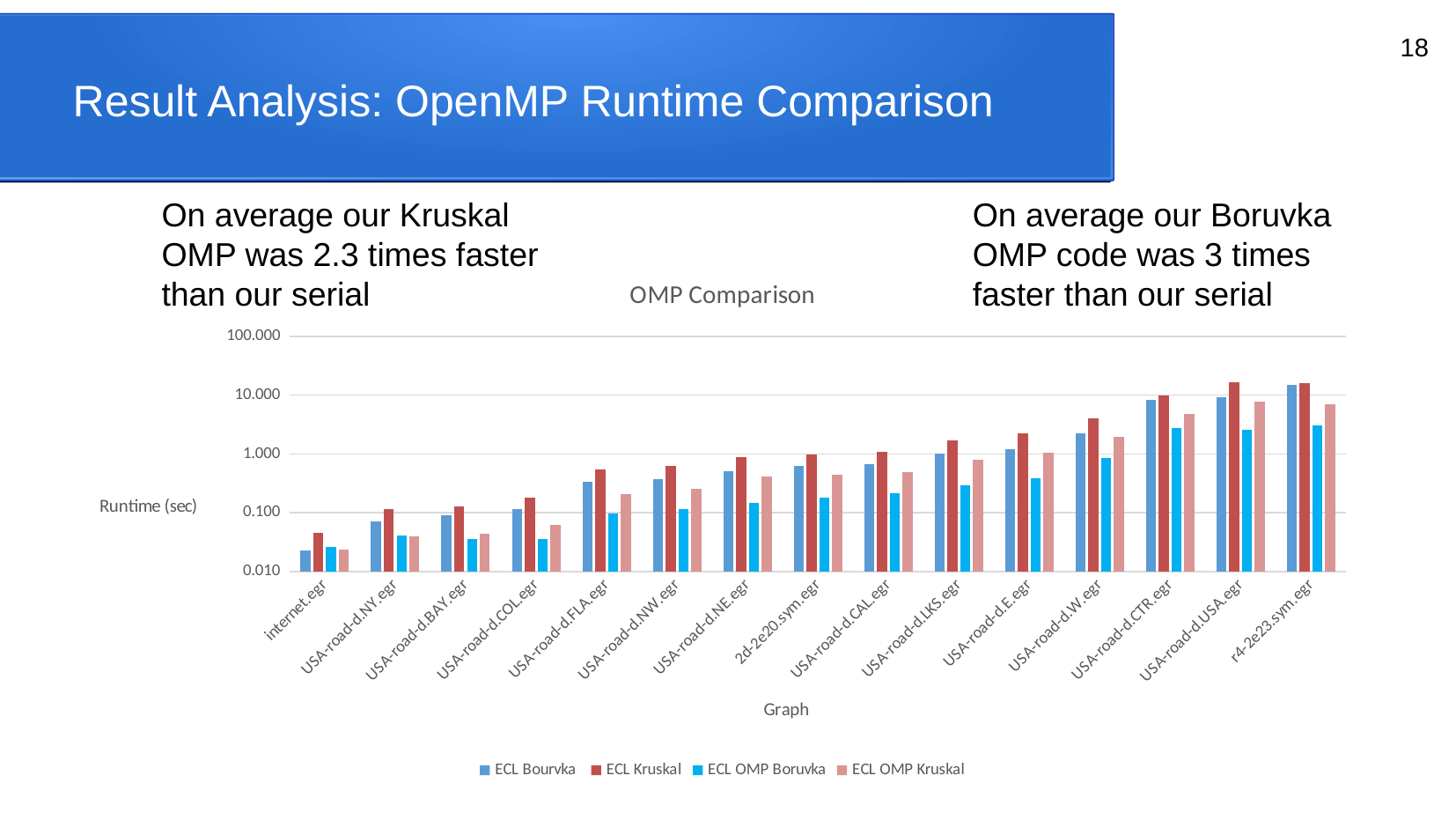
What is the label of the y axis of the chart? Runtime (sec) Is the ECL OMP Boruvka value for internet.egr greater or less than 0.100? less What kind of chart is shown on the slide? bar chart How many series does the chart legend list? 4 Is the ECL Kruskal value for USA-road-d.E.egr greater or less than 1.000? greater Do the runtimes generally rise or fall moving from left to right along the x axis? rise Which graph category has the lowest ECL Bourvka runtime? internet.egr What is the title of the chart? OMP Comparison For USA-road-d.USA.egr, which is larger: ECL Kruskal or ECL OMP Boruvka? ECL Kruskal Is the ECL OMP Boruvka value for USA-road-d.CTR.egr greater or less than 1.000? greater How many graph categories are shown on the x axis of the chart? 15